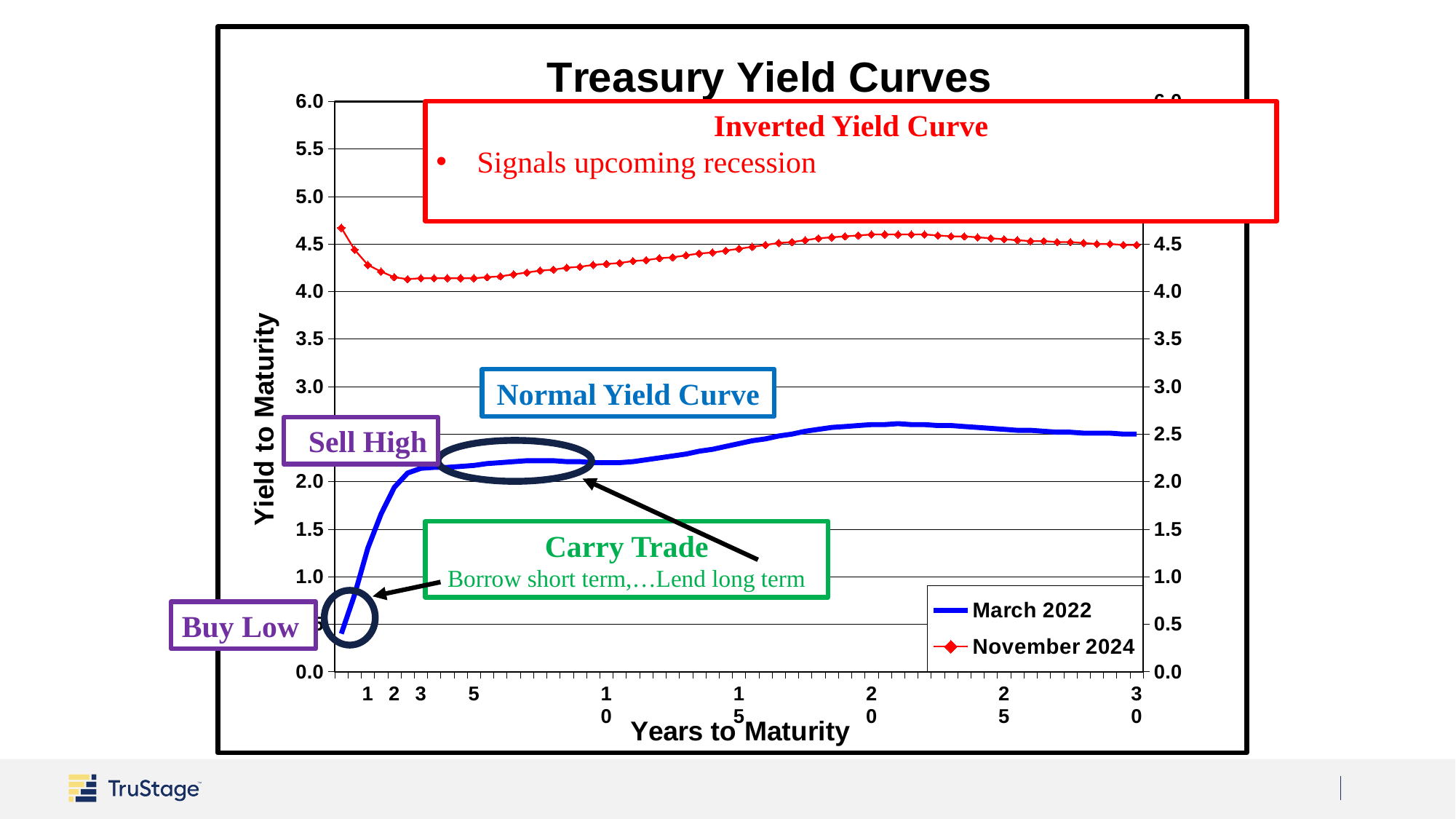
At 10 years to maturity, which series has the higher yield, March 2022 or November 2024? November 2024 How many series does the legend list? 2 Is the November 2024 value at 5 years to maturity greater or less than 4.0? greater Does the November 2024 curve rise or fall between 1 and 3 years to maturity? fall Does the March 2022 curve rise or fall between 1 and 5 years to maturity? rise Which series is drawn in red with diamond markers? November 2024 Is the November 2024 value at 5 years to maturity greater or less than 4.5? less Is the March 2022 value at 10 years to maturity greater or less than 2.5? less What kind of chart is shown on the slide? line chart What is the title of the chart? Treasury Yield Curves